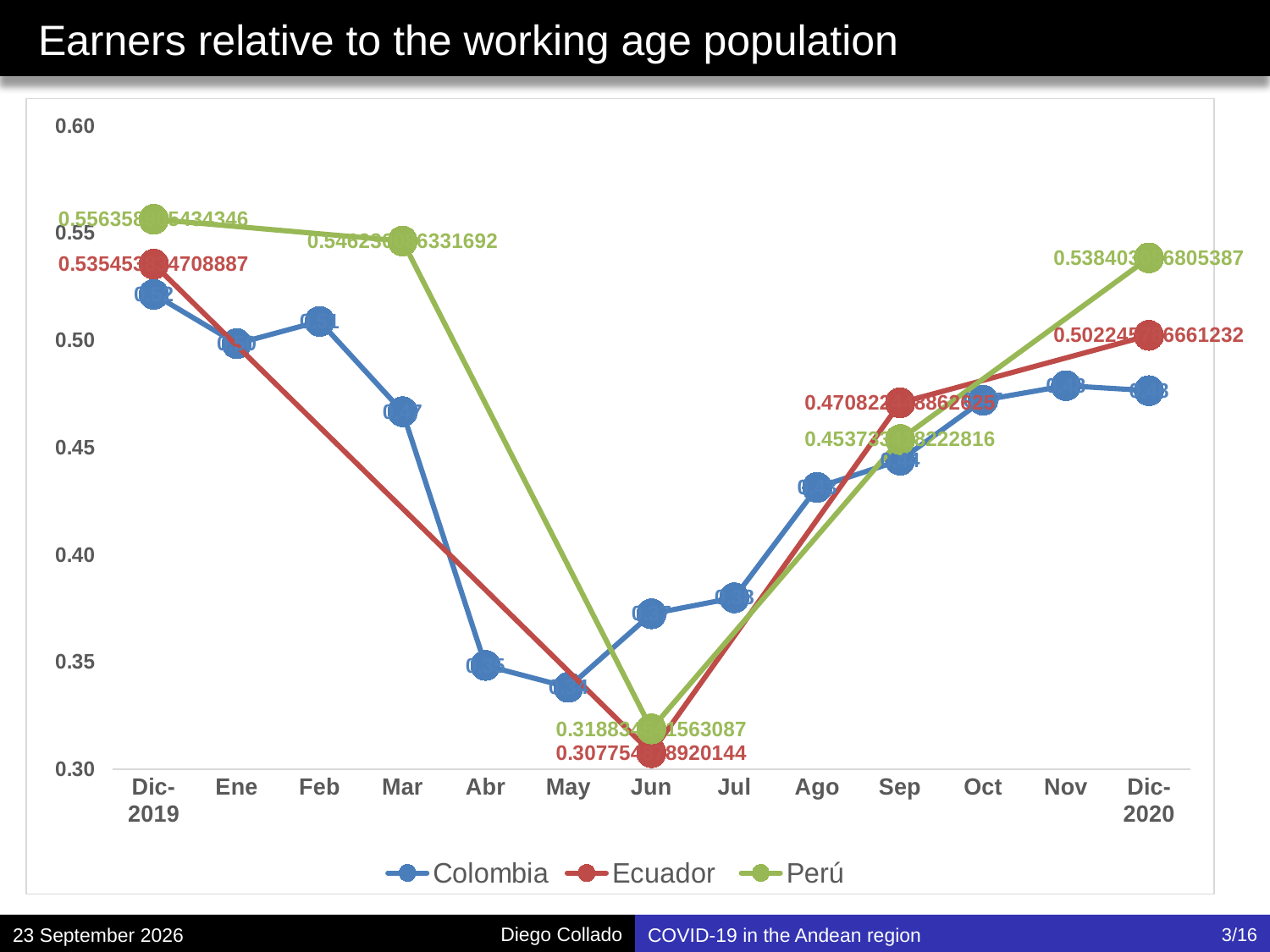
In which month is the Perú series highest? Dic-2019 Is the value for Colombia in May greater or less than 0.35? less What kind of chart is shown on the slide? line chart In Jun, which series has the higher value, Ecuador or Perú? Perú In which month does the Perú series reach its lowest value? Jun What colour is the Ecuador line? red In Sep, which series has the higher value, Ecuador or Perú? Ecuador How many months are shown along the x axis? 13 In which month does the Colombia series reach its lowest value? May How many series does the legend list? 3 Does the Colombia series rise or fall from Jun to Nov? rise